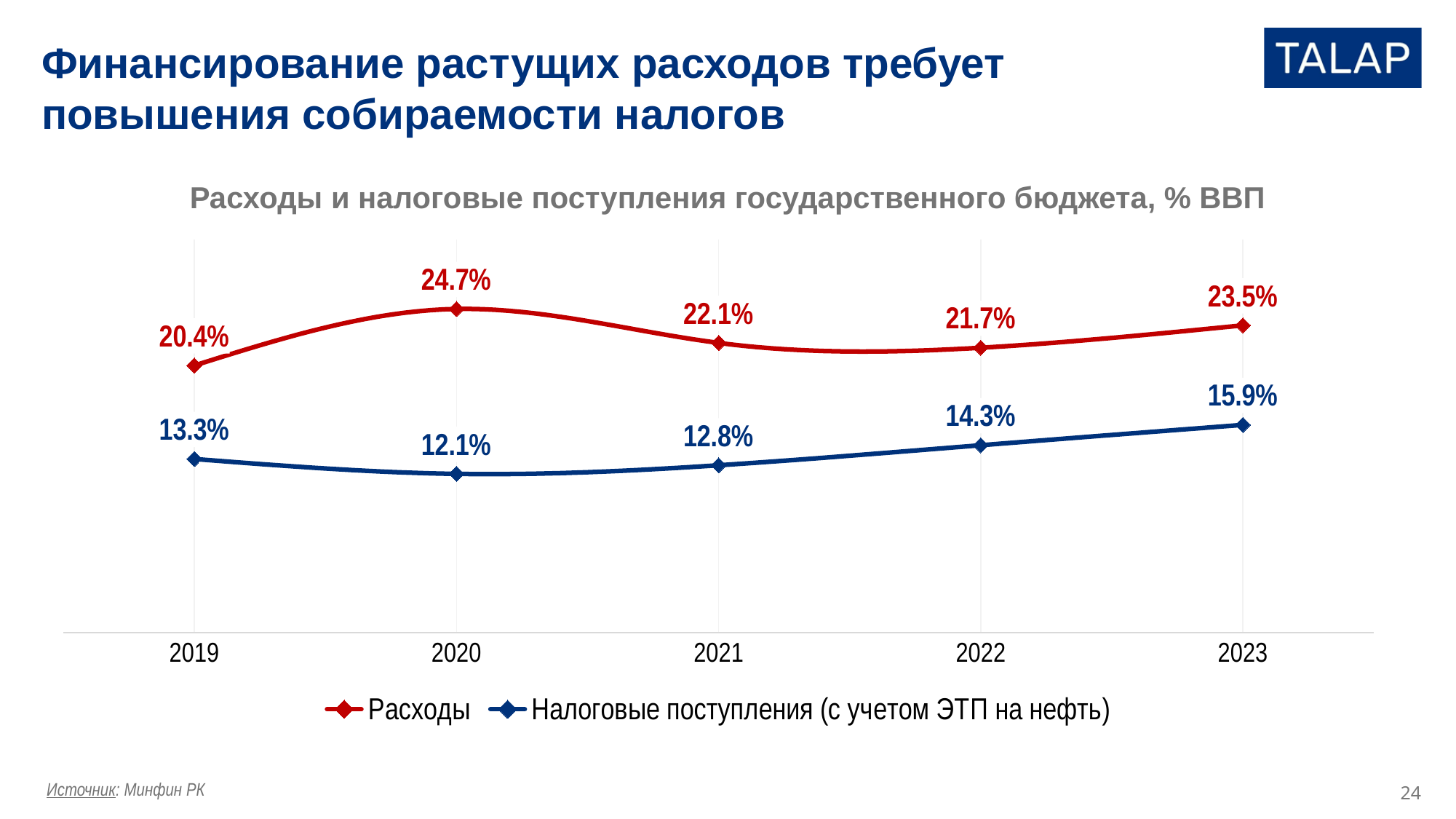
What kind of chart is shown on the slide? Line chart What is the difference between Расходы and Налоговые поступления (с учетом ЭТП на нефть) in 2023? 7.6% What is the value of Расходы in 2020? 24.7% Does Налоговые поступления (с учетом ЭТП на нефть) rise or fall from 2020 to 2023? Rise What is the value of Налоговые поступления (с учетом ЭТП на нефть) in 2021? 12.8% How many years are shown on the x axis? 5 How many series does the legend list? 2 Which is larger: Расходы in 2021 or Расходы in 2022? Расходы in 2021 What is the difference between Расходы in 2020 and Расходы in 2019? 4.3% What is the value of Налоговые поступления (с учетом ЭТП на нефть) in 2023? 15.9% In which year is Налоговые поступления (с учетом ЭТП на нефть) lowest? 2020 In which year is Расходы highest? 2020